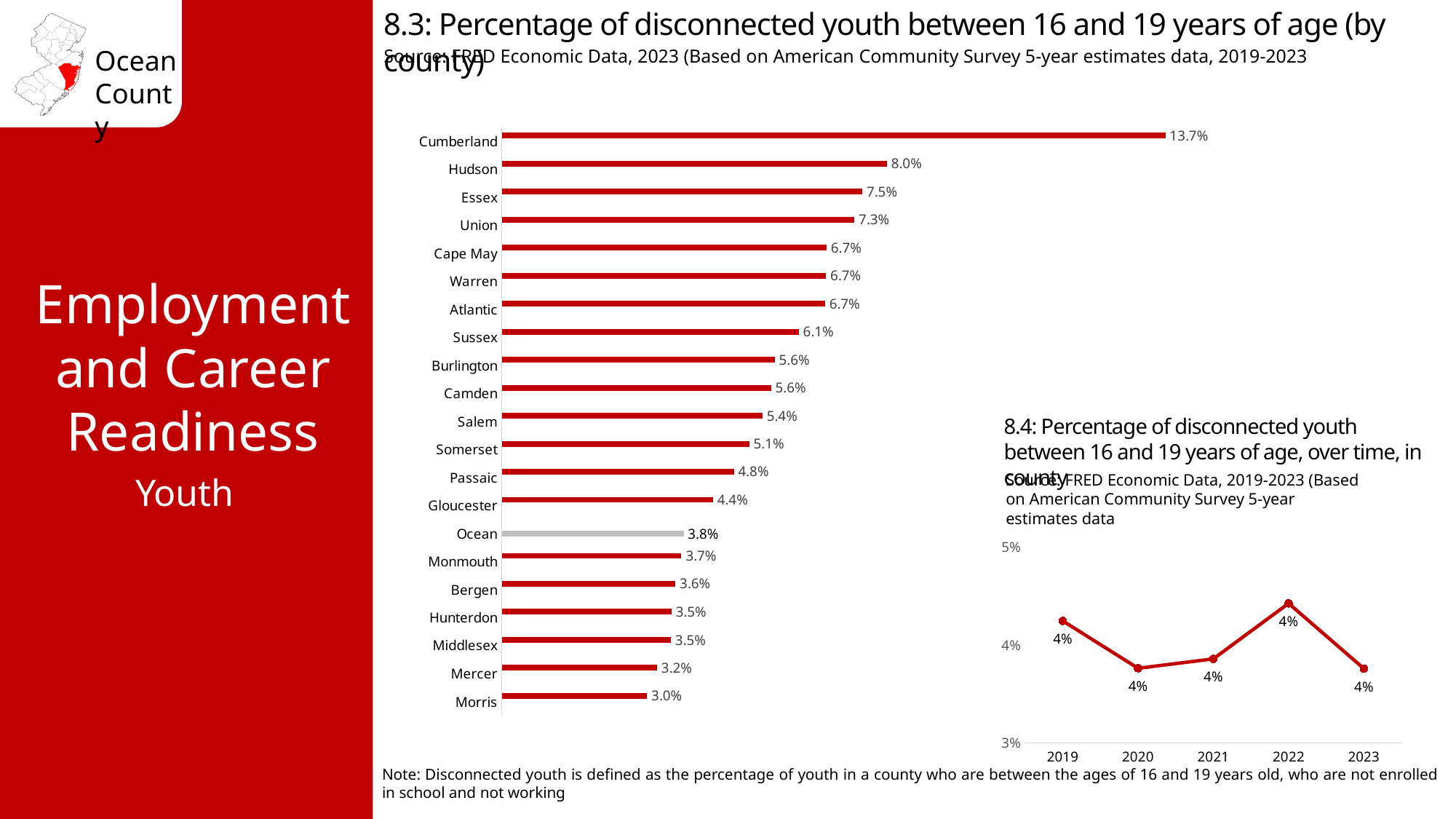
In chart 8.4, what is the labelled value for 2022? 4% In chart 8.3, what is the percentage of disconnected youth for Ocean County? 3.8% In chart 8.3, what is the difference between Cumberland's and Hudson's percentages? 5.7% In chart 8.3, what is the percentage of disconnected youth for Sussex? 6.1% How many counties are shown in chart 8.3? 21 In chart 8.3, which county has a higher percentage, Hudson or Essex? Hudson In chart 8.3, which county has the lowest percentage of disconnected youth? Morris How many years are plotted in chart 8.4? 5 What kind of chart is chart 8.4? Line chart What kind of chart is chart 8.3? Bar chart In chart 8.3, which county's bar is coloured grey instead of red? Ocean In chart 8.3, which county has the highest percentage of disconnected youth? Cumberland